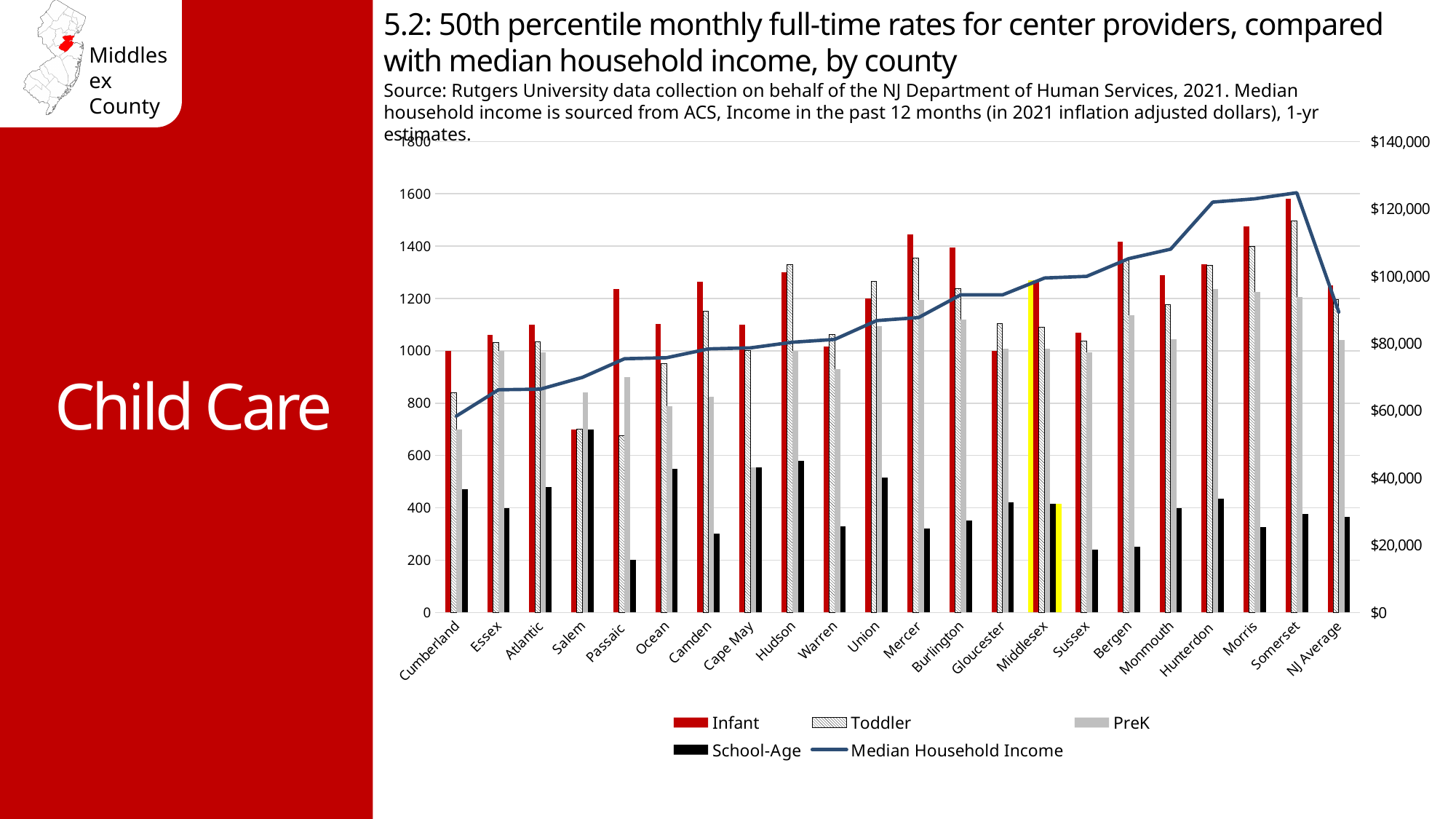
Which county has the lowest Median Household Income? Cumberland Which county has the lowest School-Age rate? Passaic Is the Infant rate for Somerset greater or less than 1400? greater Is the Median Household Income for Cumberland greater or less than $80,000? less How many counties/categories are shown on the x axis of the chart? 22 Which county has the lowest Infant rate? Salem What kind of chart is shown on the slide? Bar chart with a line Which county has the highest Infant rate? Somerset Which is larger, the School-Age rate for Salem or the School-Age rate for Cumberland? Salem How many series does the chart legend list? 5 Which county has the highest School-Age rate? Salem Does the Median Household Income line generally rise or fall from Cumberland to Somerset? rise